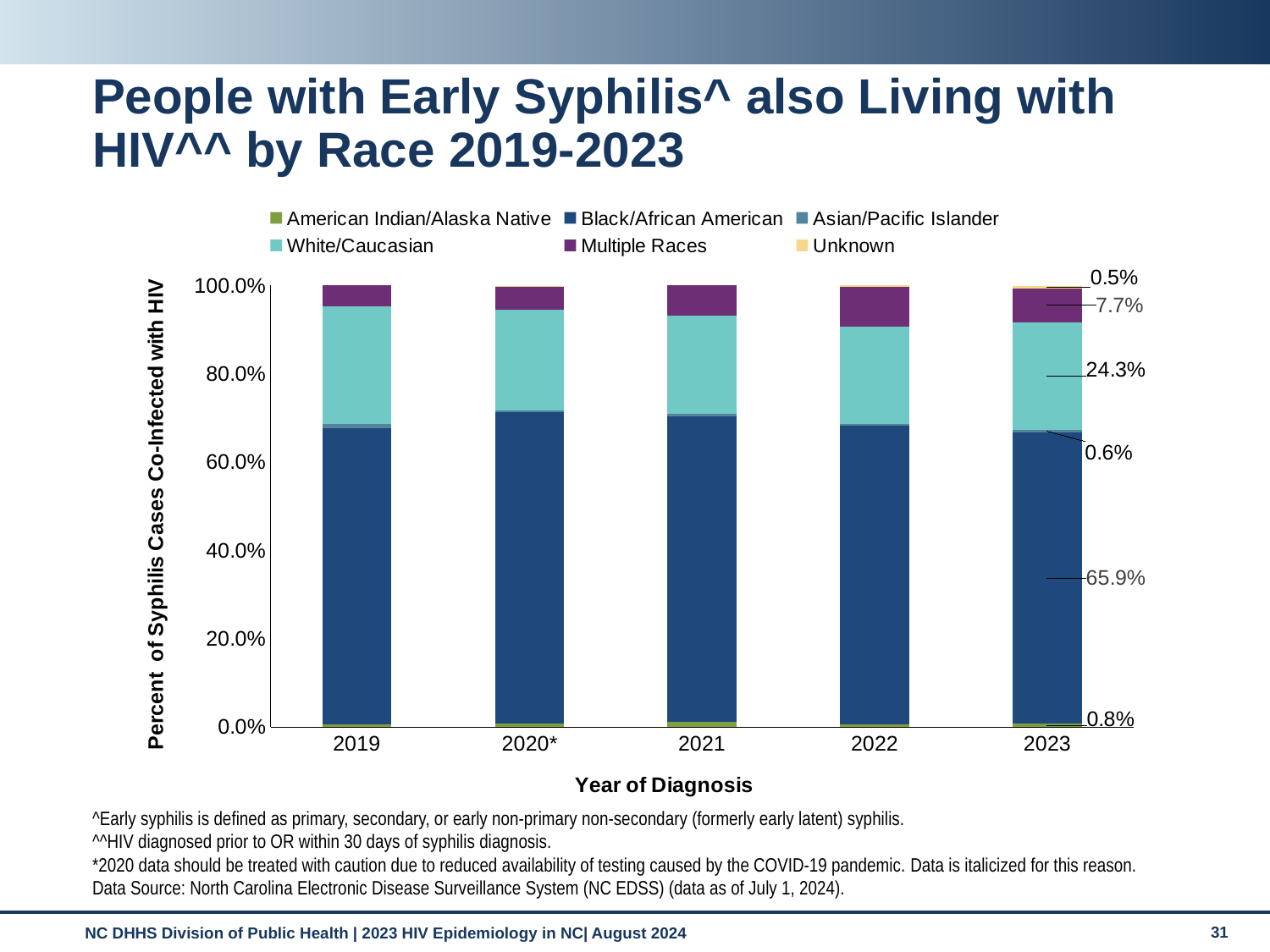
What percentage of syphilis cases co-infected with HIV in 2023 were American Indian/Alaska Native? 0.8% How many years are shown on the x axis? 5 What is the difference between the Black/African American and White/Caucasian shares in 2023? 41.6% What percentage of syphilis cases co-infected with HIV in 2023 were of Multiple Races? 7.7% What percentage of syphilis cases co-infected with HIV in 2023 had Unknown race? 0.5% How many series does the legend list? 6 What percentage of syphilis cases co-infected with HIV in 2023 were White/Caucasian? 24.3% Which race group had the largest share of syphilis cases co-infected with HIV in 2023? Black/African American What percentage of syphilis cases co-infected with HIV in 2023 were Black/African American? 65.9% What percentage of syphilis cases co-infected with HIV in 2023 were Asian/Pacific Islander? 0.6% Is the Black/African American share in 2021 greater or less than 60.0%? greater What type of chart is shown on the slide? Stacked bar chart